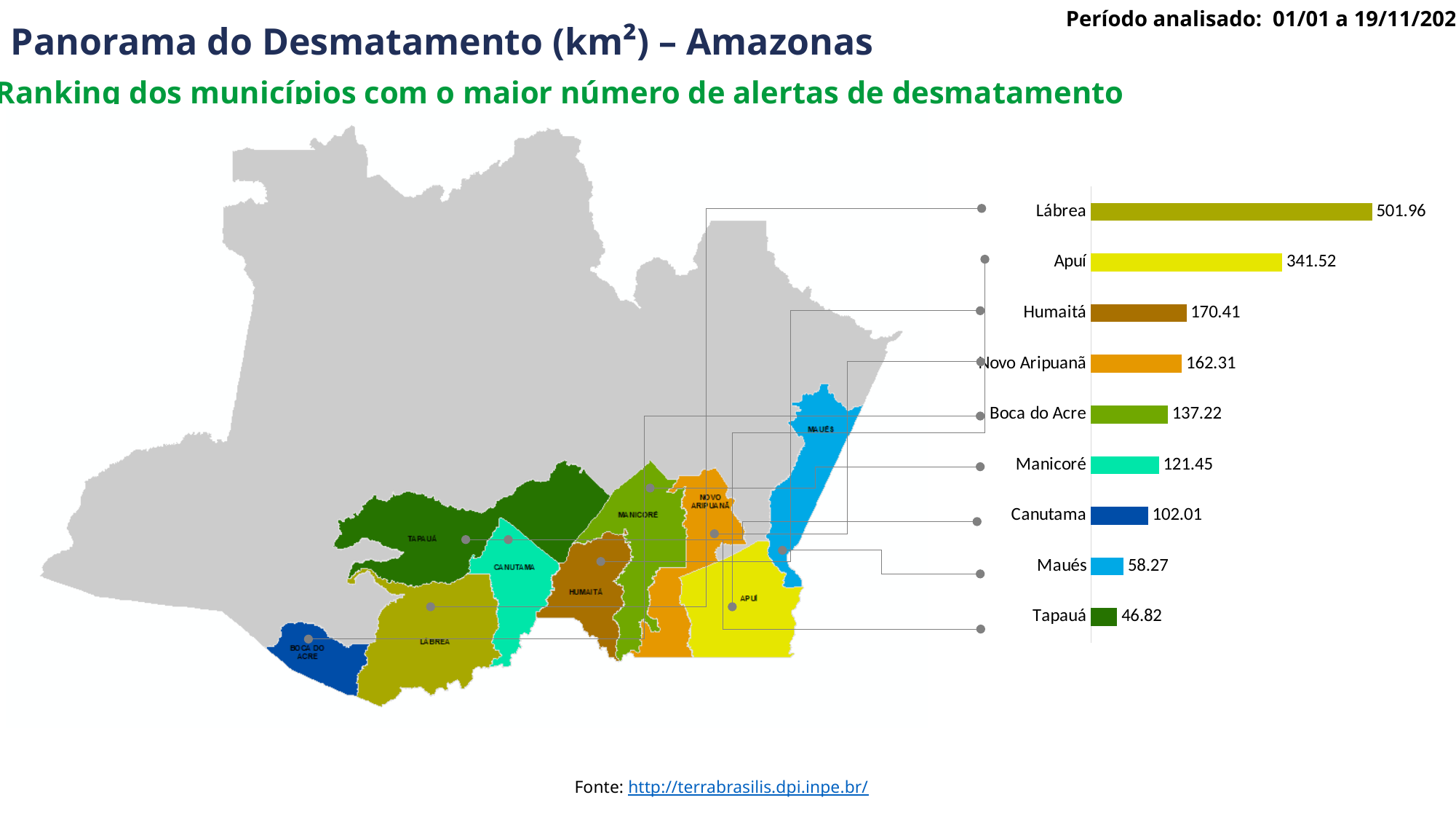
What value is shown for Maués? 58.27 What is the difference between the values for Maués and Tapauá? 11.45 How many municipalities are shown in the bar chart? 9 Which municipality has the lowest value in the bar chart? Tapauá What value is shown for Novo Aripuanã? 162.31 Which has a larger value, Boca do Acre or Manicoré? Boca do Acre Which has a larger value, Canutama or Apuí? Apuí What is the difference between the values for Lábrea and Apuí? 160.44 What is the value shown for Humaitá? 170.41 What is the deforestation value shown for Lábrea? 501.96 What kind of chart is used to rank the municipalities? Bar chart Which municipality has the highest value in the bar chart? Lábrea